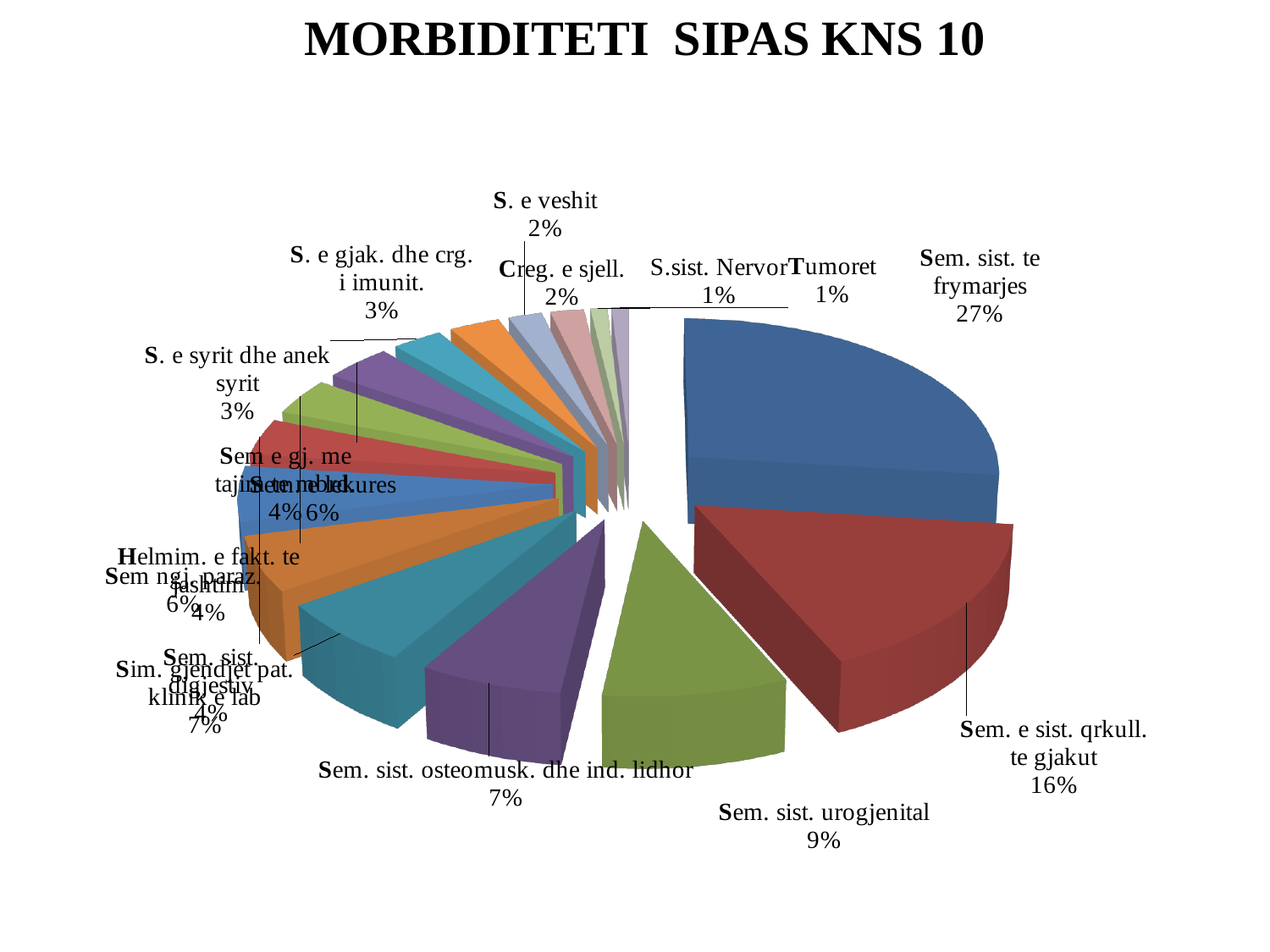
What share of the pie does Sem. e sist. qrkull. te gjakut have? 16% What is the value shown for S. e veshit? 2% What is the value shown for Sem. sist. osteomusk. dhe ind. lidhor? 7% What kind of chart is shown on the slide? pie chart Which category has the largest share of the pie? Sem. sist. te frymarjes What is the difference in percentage points between Sem. sist. te frymarjes and Sem. e sist. qrkull. te gjakut? 11 percentage points What is the value shown for S. e syrit dhe anek syrit? 3% What is the value shown for Sem. sist. urogjenital? 9% Which is larger, the share for Sem. sist. urogjenital or the share for Sem. sist. osteomusk. dhe ind. lidhor? Sem. sist. urogjenital What is the value shown for Tumoret? 1% What share of the pie does Sem. sist. te frymarjes have? 27% What is the title of the chart? MORBIDITETI SIPAS KNS 10